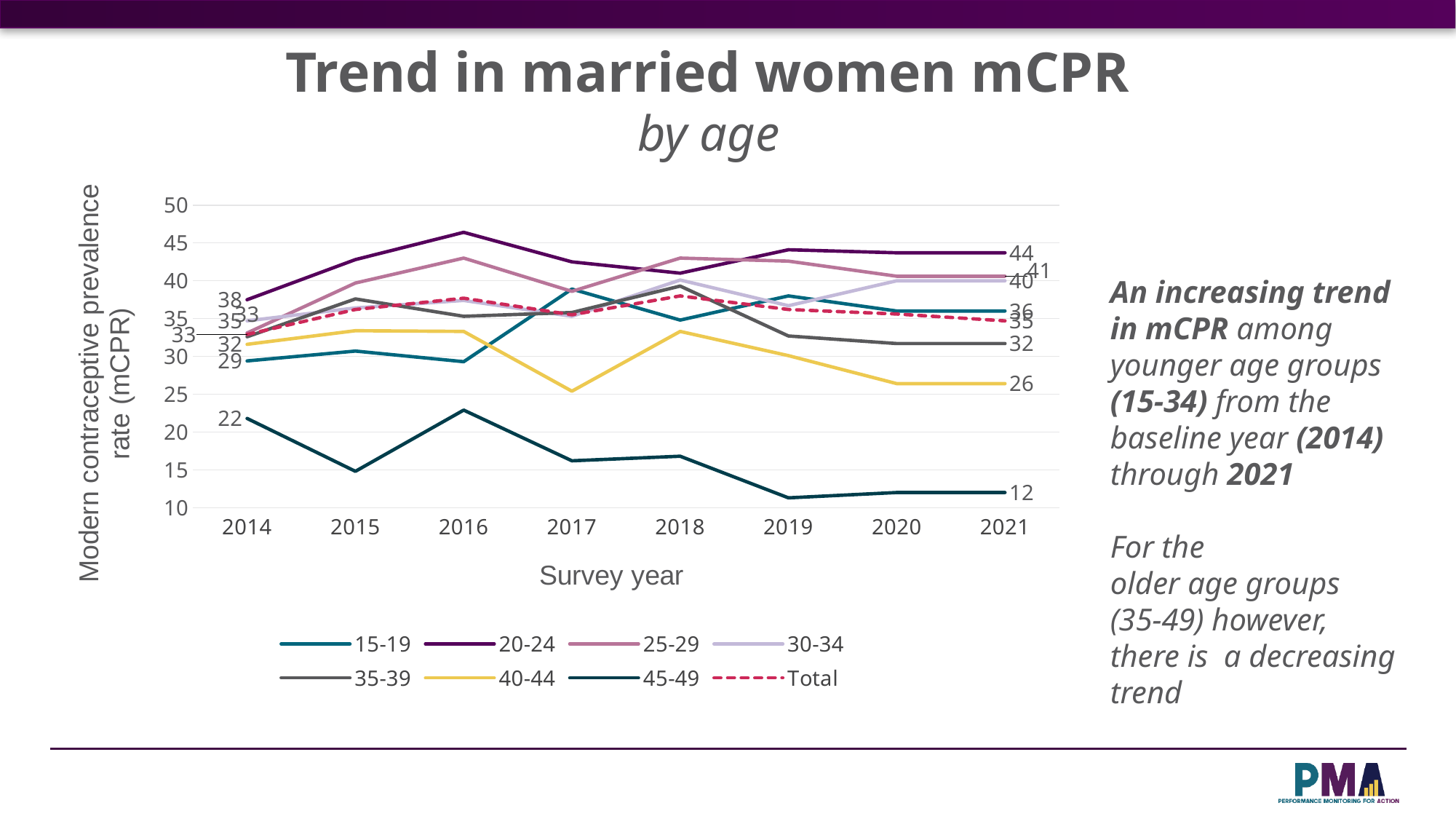
How many series does the legend list? 8 Does the mCPR for the 45-49 age group rise or fall from 2014 to 2021? fall How many survey years are plotted on the x axis? 8 What is the mCPR value for the 40-44 age group in 2021? 26 What is the mCPR value for the 45-49 age group in 2021? 12 By how much did the mCPR for the 45-49 age group fall from 2014 to 2021? 10 Which age group has the lowest mCPR in 2021? 45-49 What type of chart is shown on the slide? line chart What is the mCPR value for the 20-24 age group in 2021? 44 Which age group has the highest mCPR in 2021? 20-24 Is the mCPR value for the 20-24 age group in 2016 greater or less than 45? greater What is the mCPR value for the 45-49 age group in 2014? 22